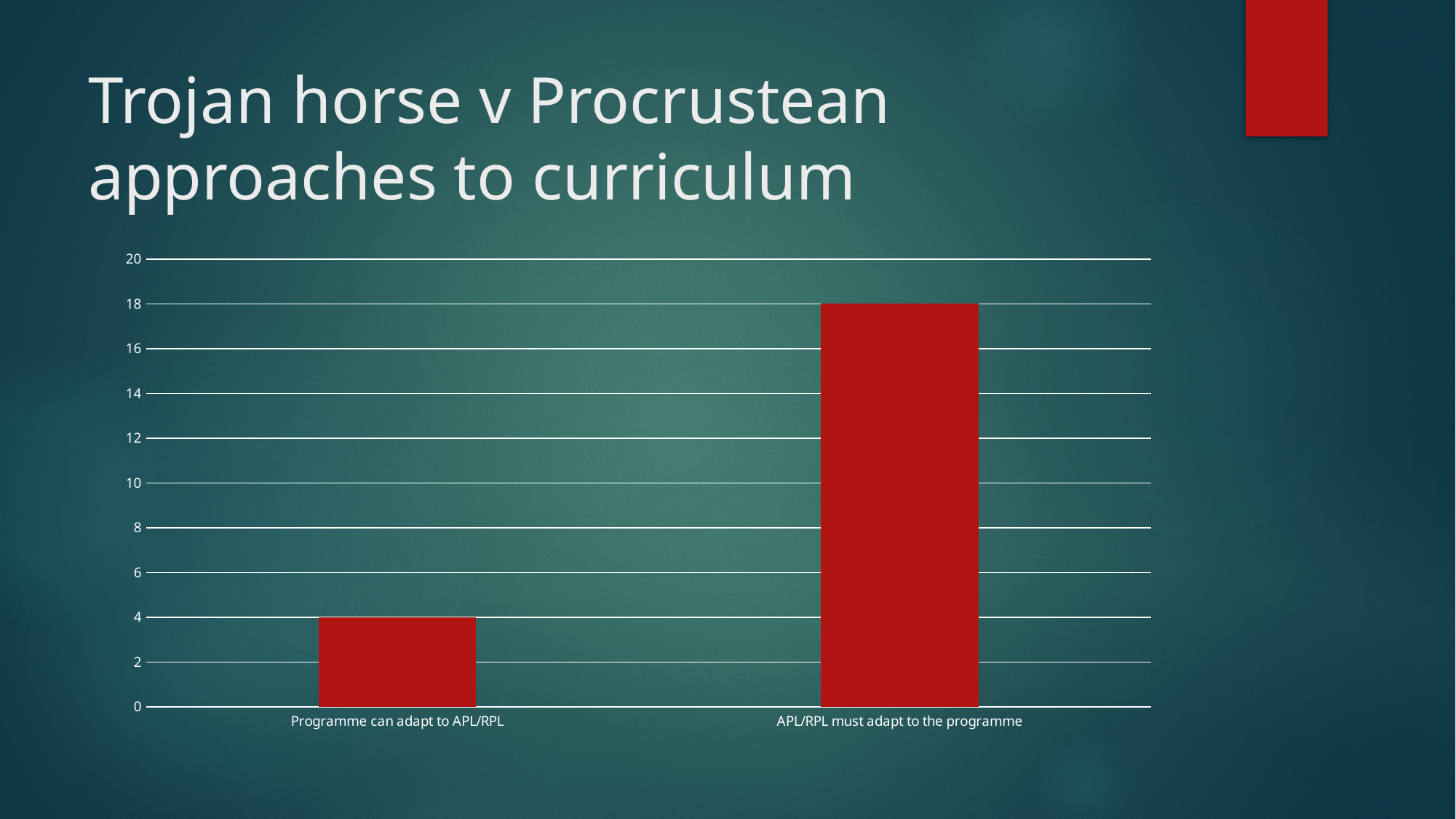
What kind of chart is shown on the slide? Bar chart Which category has the lowest value? Programme can adapt to APL/RPL Is the value for "Programme can adapt to APL/RPL" greater or less than 10? less How many categories are shown on the x axis? 2 What colour are the bars in the chart? Red What is the value for "Programme can adapt to APL/RPL"? 4 Which category has the highest value? APL/RPL must adapt to the programme What is the difference between the values for "APL/RPL must adapt to the programme" and "Programme can adapt to APL/RPL"? 14 What is the maximum value shown on the vertical axis? 20 Is the value for "APL/RPL must adapt to the programme" greater or less than 10? greater Which is larger: the value for "Programme can adapt to APL/RPL" or the value for "APL/RPL must adapt to the programme"? APL/RPL must adapt to the programme What is the value for "APL/RPL must adapt to the programme"? 18